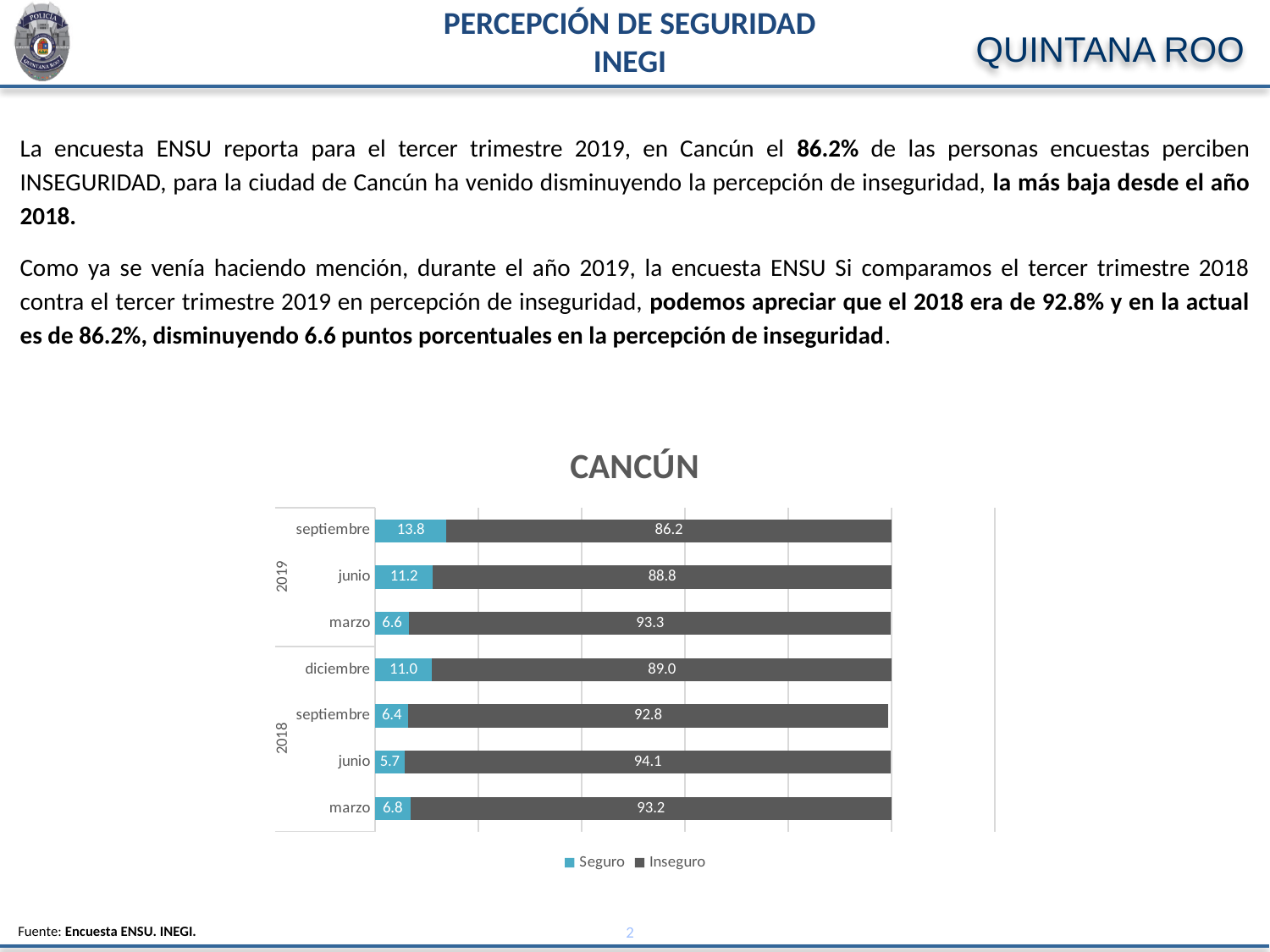
How many periods (bars) are shown in the CANCÚN chart? 7 Which period has the lowest Inseguro value in the CANCÚN chart? septiembre 2019 What is the total of the stacked bar for junio 2019 in the CANCÚN chart? 100.0 Which is larger in the CANCÚN chart: the Seguro value for junio 2019 or the Seguro value for marzo 2019? junio 2019 What kind of chart is the CANCÚN chart? stacked bar chart What is the Seguro value for diciembre 2018 in the CANCÚN chart? 11.0 How many series does the legend of the CANCÚN chart list? 2 What is the difference between the Inseguro values for septiembre 2018 and septiembre 2019 in the CANCÚN chart? 6.6 What is the Seguro value for junio 2018 in the CANCÚN chart? 5.7 Which series is shown in dark grey in the CANCÚN chart? Inseguro What is the Inseguro value for septiembre 2019 in the CANCÚN chart? 86.2 Which period has the highest Seguro value in the CANCÚN chart? septiembre 2019